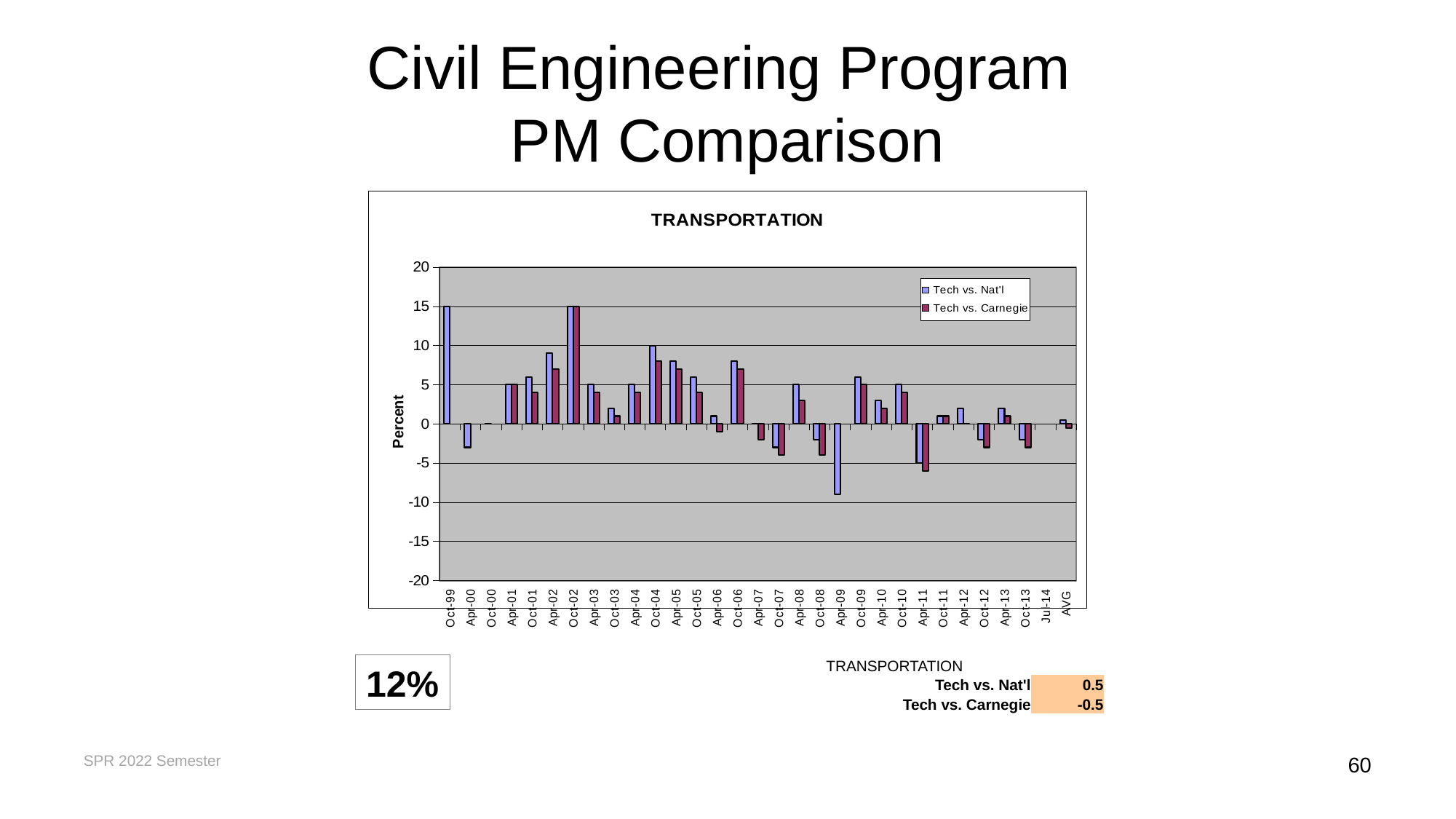
At which period is the Tech vs. Nat'l value lowest? Apr-09 What kind of chart is shown on the slide? bar chart What is the title of the chart? TRANSPORTATION Is the Tech vs. Nat'l value for Oct-04 greater or less than 5? greater What is the AVG value for Tech vs. Nat'l? 0.5 What is the Tech vs. Nat'l value for Oct-99? 15 What is the AVG value for Tech vs. Carnegie? -0.5 How many series does the legend of the TRANSPORTATION chart list? 2 Is the Tech vs. Nat'l value for Apr-09 greater or less than -5? less What is the label on the vertical axis of the chart? Percent For Apr-02, which is larger: Tech vs. Nat'l or Tech vs. Carnegie? Tech vs. Nat'l At which period is the Tech vs. Carnegie value highest? Oct-02